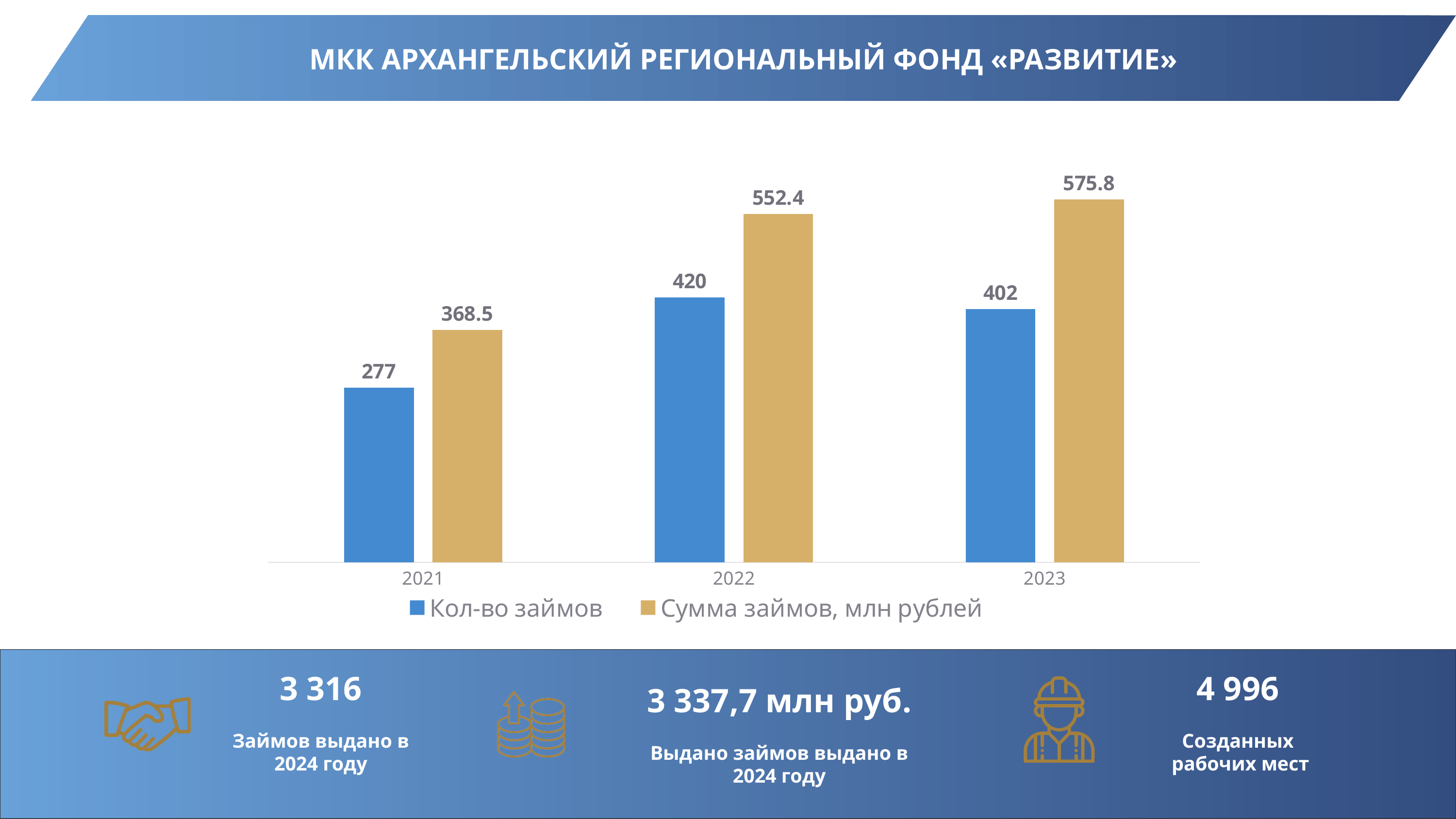
What is the value of Сумма займов, млн рублей for 2023? 575.8 How many years are shown on the x axis of the chart? 3 How many series does the legend list? 2 What is the difference between the Кол-во займов values for 2022 and 2023? 18 Which year has the lowest value for Сумма займов, млн рублей? 2021 What is the difference between the Сумма займов, млн рублей values for 2023 and 2021? 207.3 Which is larger: Кол-во займов in 2021 or in 2023? 2023 What is the value of Кол-во займов for 2021? 277 Does the Сумма займов, млн рублей series rise or fall from 2021 to 2023? rise What kind of chart is shown on the slide? bar chart What is the value of Сумма займов, млн рублей for 2022? 552.4 Which year has the highest value for Кол-во займов? 2022